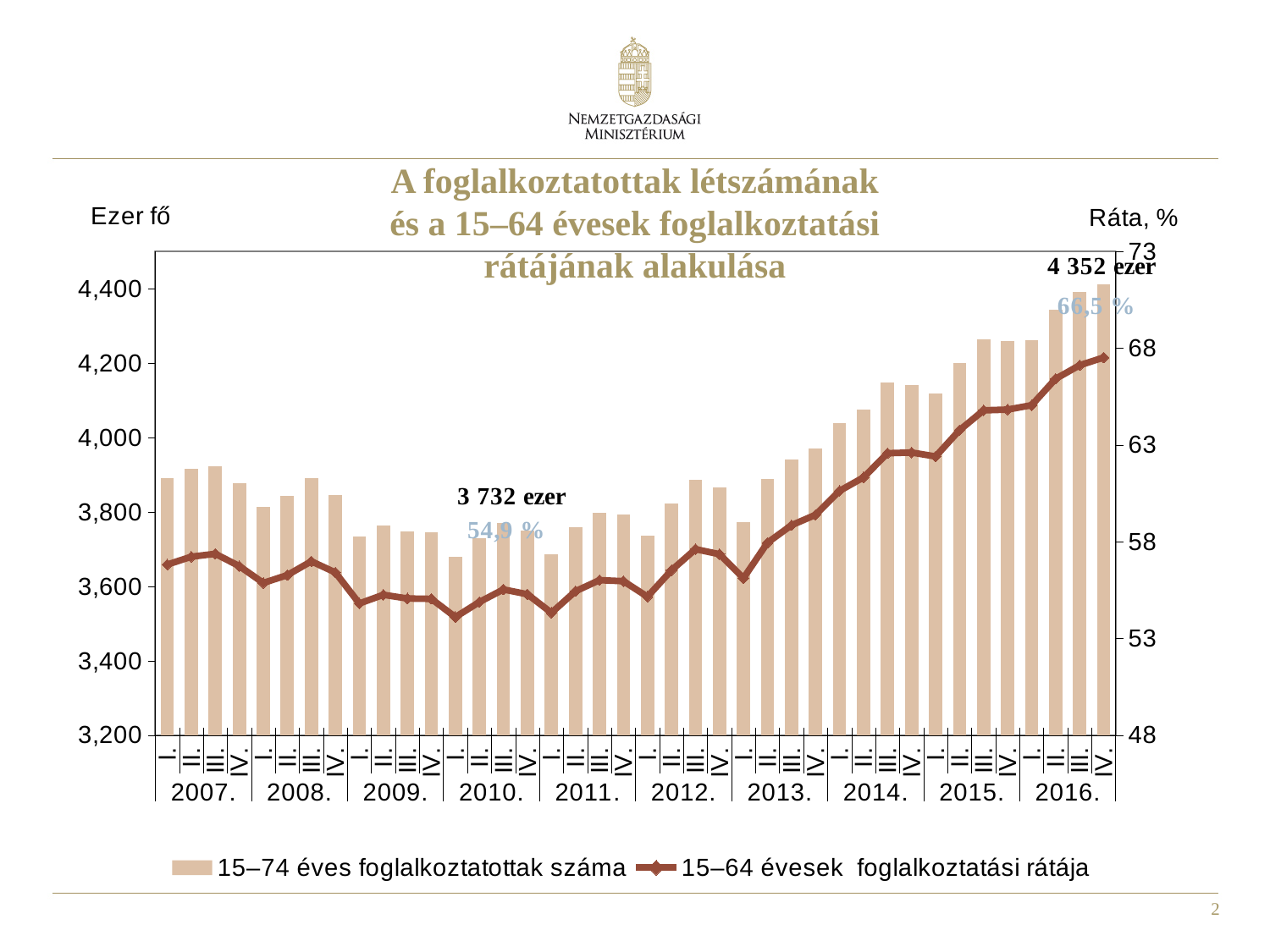
What kind of chart is shown on the slide? A combined bar and line chart In which quarter is the bar for the number of employed persons the lowest? 2010 I. How does the employment rate line move from 2013 to 2016? It rises How many series does the legend list? 2 Is the number of employed persons in 2007 I. greater or less than 3,800? greater In which quarter is the bar for the number of employed persons the highest? 2016 IV. What is the difference between the two labelled employment figures, 4 352 ezer and 3 732 ezer? 620 ezer What is the difference between the two labelled employment rates, 66,5 % and 54,9 %? 11,6 percentage points How many years are shown on the x axis? 10 Is the number of employed persons in 2015 I. greater or less than 4,000? greater